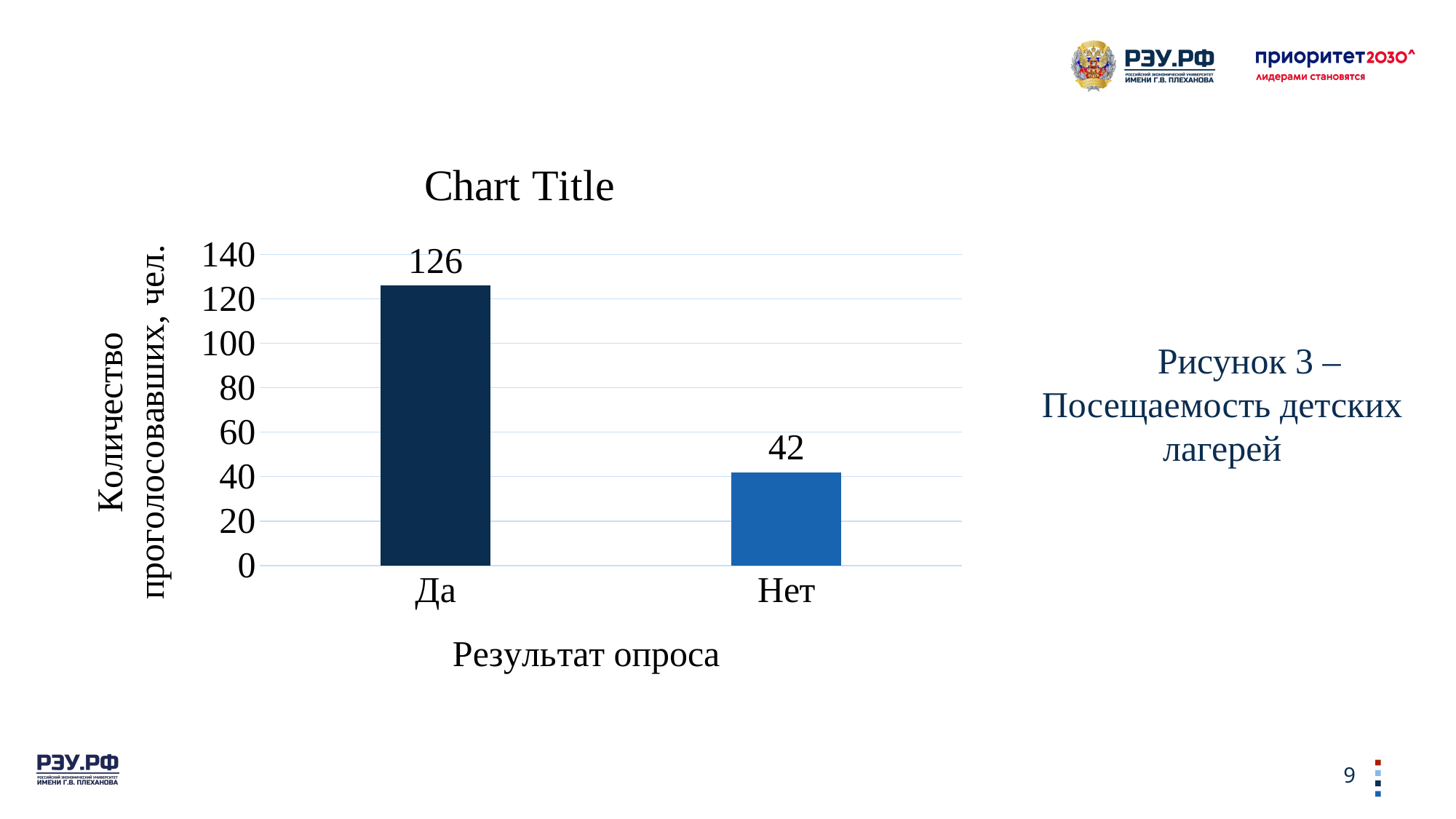
What kind of chart is shown on the slide? bar chart What is the value for Нет? 42 What is the value for Да? 126 What is the title of the chart? Chart Title What is the difference between the values for Да and Нет? 84 What is the label of the x axis? Результат опроса Which category has the highest value? Да How many categories are shown on the x axis? 2 Is the value for Да greater or less than 100? greater Is the value for Нет greater or less than 60? less Which is larger, the value for Да or the value for Нет? Да Which category has the lowest value? Нет